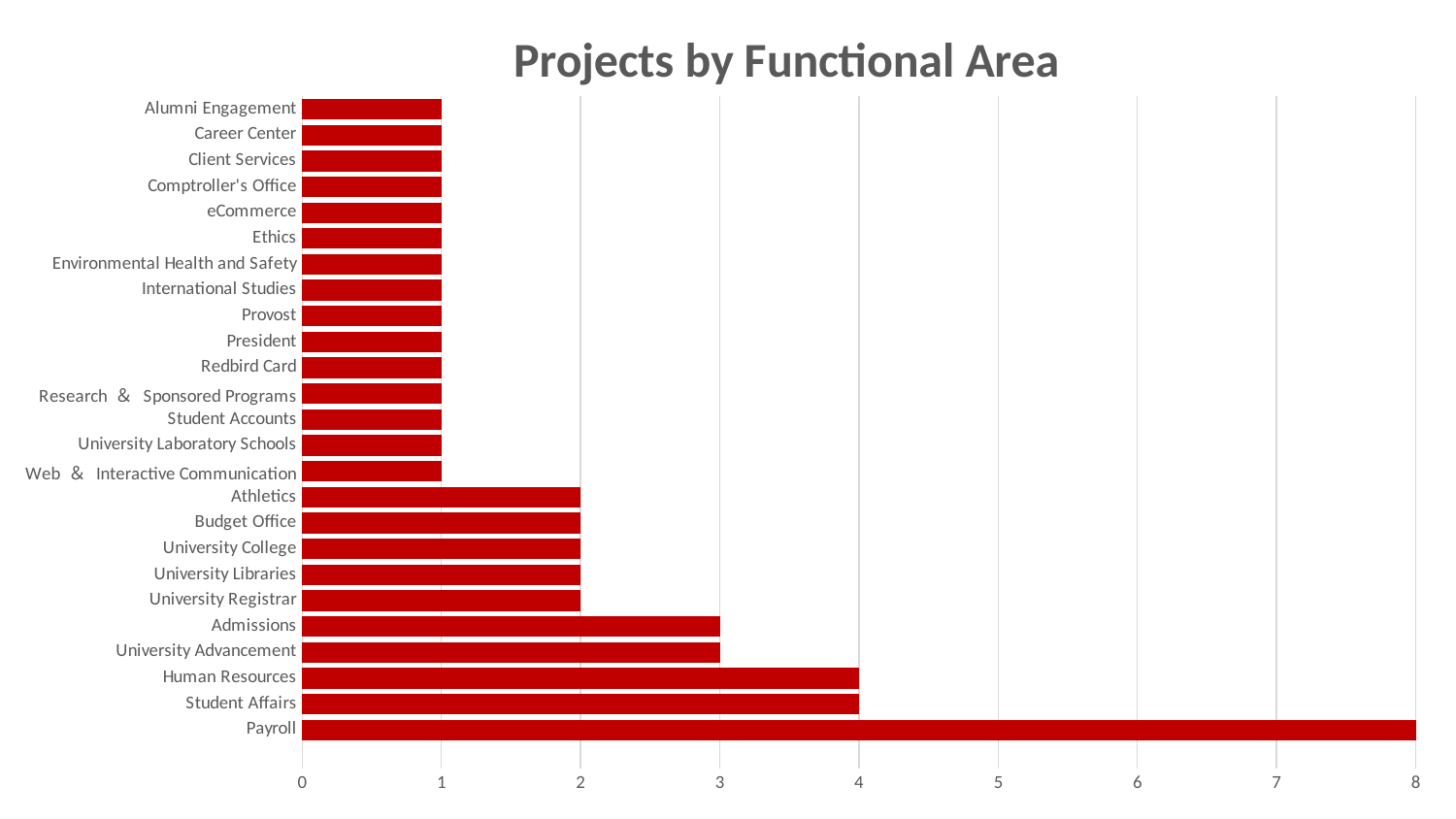
What is the title of the chart? Projects by Functional Area What is the value for Human Resources? 4 What is the value for Admissions? 3 What is the value for Athletics? 2 Is the value for Payroll greater or less than 5? greater How many functional areas are shown on the chart? 25 What is the value for Payroll? 8 What is the difference between the values for Payroll and Student Affairs? 4 Which is larger, the value for University Advancement or the value for University Registrar? University Advancement What kind of chart is shown on the slide? bar chart What is the value for Redbird Card? 1 Which functional area has the highest value? Payroll